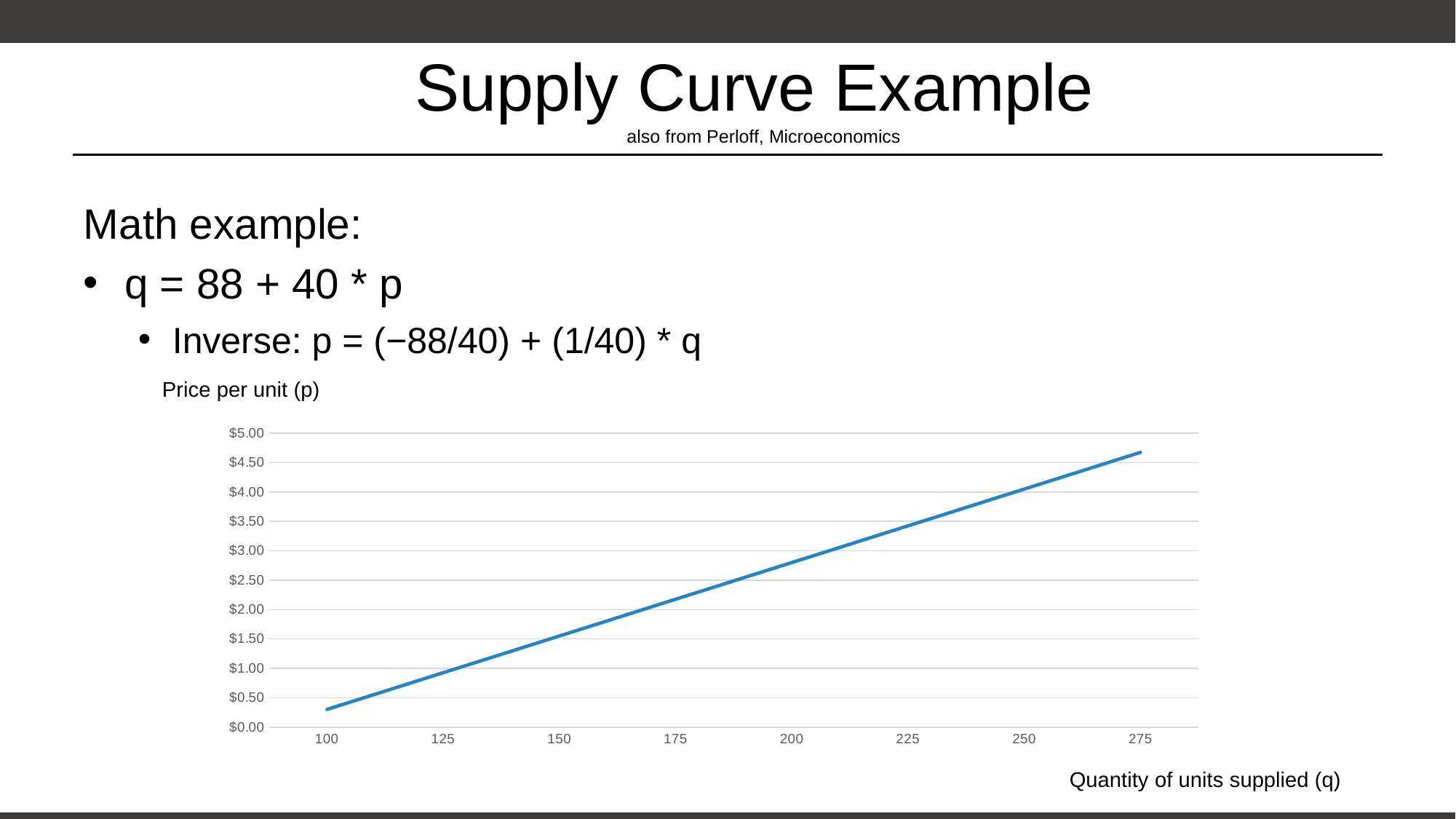
What kind of chart is shown on the slide? line chart Is the price per unit at a quantity of 250 greater or less than $3.50? greater Is the price per unit at a quantity of 100 greater or less than $0.50? less At which labelled quantity on the x axis is the price per unit lowest? 100 Is the price per unit at a quantity of 200 greater or less than $2.50? greater Does the price per unit rise or fall as the quantity of units supplied increases along the x axis? rise At which labelled quantity on the x axis is the price per unit highest? 275 Which has the higher price per unit: a quantity of 150 or a quantity of 250? 250 What is the label of the vertical axis of the chart? Price per unit (p)